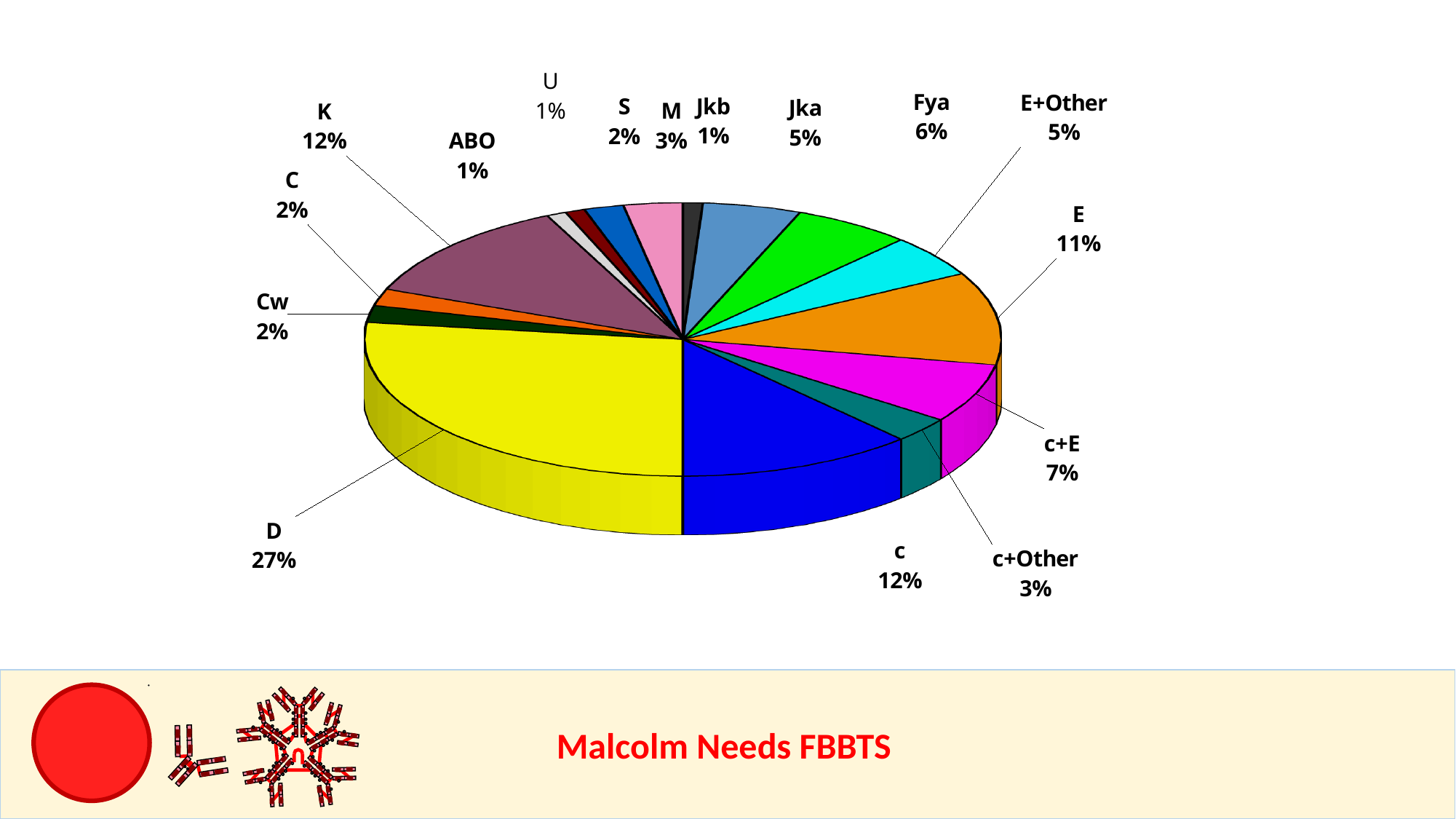
What percentage share does c+Other have in the pie chart? 3% What percentage share does c+E have in the pie chart? 7% What percentage share does Fya have in the pie chart? 6% What percentage share does E have in the pie chart? 11% How many categories are shown in the pie chart? 16 What is the difference in percentage points between Fya and Jka? 1 What kind of chart is shown on the slide? pie chart Which category has the largest slice of the pie chart? D What is the difference in percentage points between D and c? 15 What percentage share does K have in the pie chart? 12% Which has a larger share, E or c+E? E What percentage share does D have in the pie chart? 27%